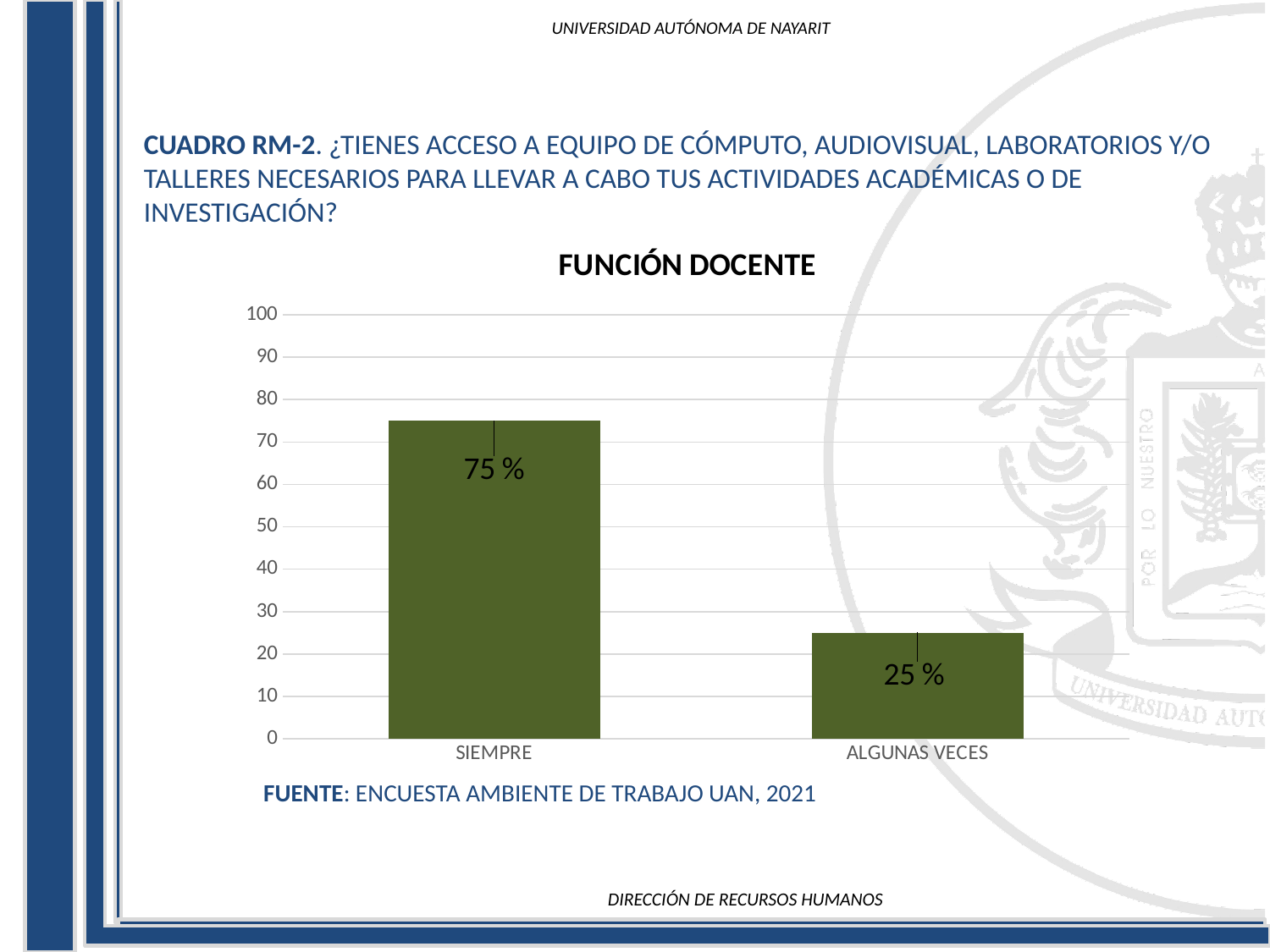
Which category has the lowest value? ALGUNAS VECES What is the title of the chart? FUNCIÓN DOCENTE What is the difference between the values for SIEMPRE and ALGUNAS VECES? 50 % What is the highest value shown on the vertical axis? 100 Is the value for ALGUNAS VECES greater or less than 30? less What kind of chart is shown on the slide? bar chart Is the value for SIEMPRE greater or less than 50? greater What is the value for SIEMPRE? 75 % Which is larger, the value for SIEMPRE or the value for ALGUNAS VECES? SIEMPRE Which category has the highest value? SIEMPRE What is the value for ALGUNAS VECES? 25 % How many categories are shown on the x axis? 2